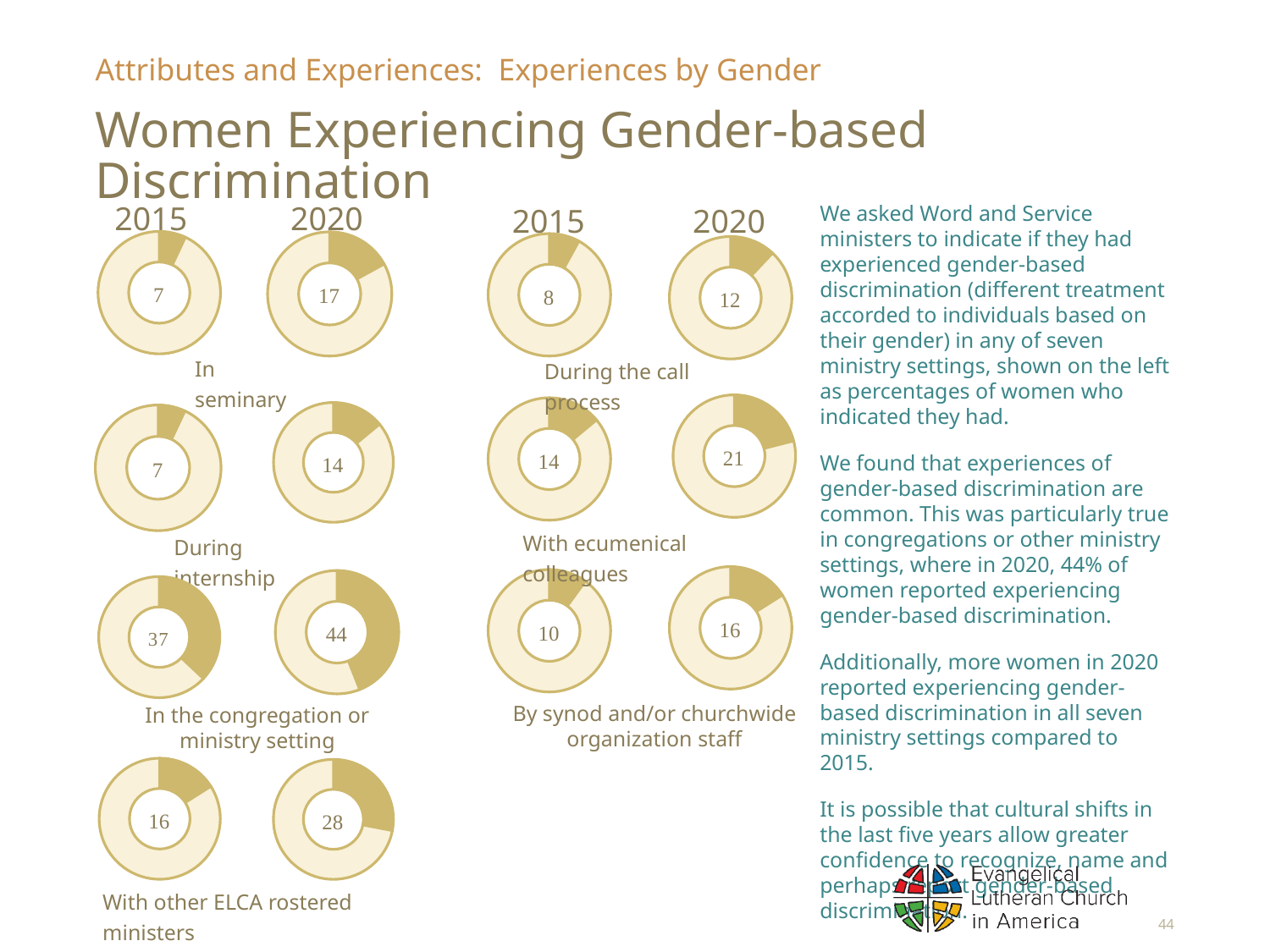
Across all the 2015 donut charts on the slide, which ministry setting has the lowest value? In seminary (tied with During internship, both 7) In the 'With other ELCA rostered ministers' donut charts, what is the difference between the 2020 and 2015 values? 12 In the 'During the call process' donut charts, what is the difference between the 2020 and 2015 values? 4 In the 'By synod and/or churchwide organization staff' donut charts, what value is shown for 2020? 16 In the 'During internship' donut charts, which year has the larger value, 2015 or 2020? 2020 What type of chart is used to show the values on this slide? Donut (pie) chart In the 'In seminary' donut charts, what value is shown for 2020? 17 How many ministry settings are shown with donut chart pairs on the slide? 7 In the 'In the congregation or ministry setting' donut charts, what value is shown for 2020? 44 In the 'In seminary' donut charts, what value is shown for 2015? 7 In the 'With ecumenical colleagues' donut charts, what value is shown for 2015? 14 Across all the 2020 donut charts on the slide, which ministry setting has the highest value? In the congregation or ministry setting